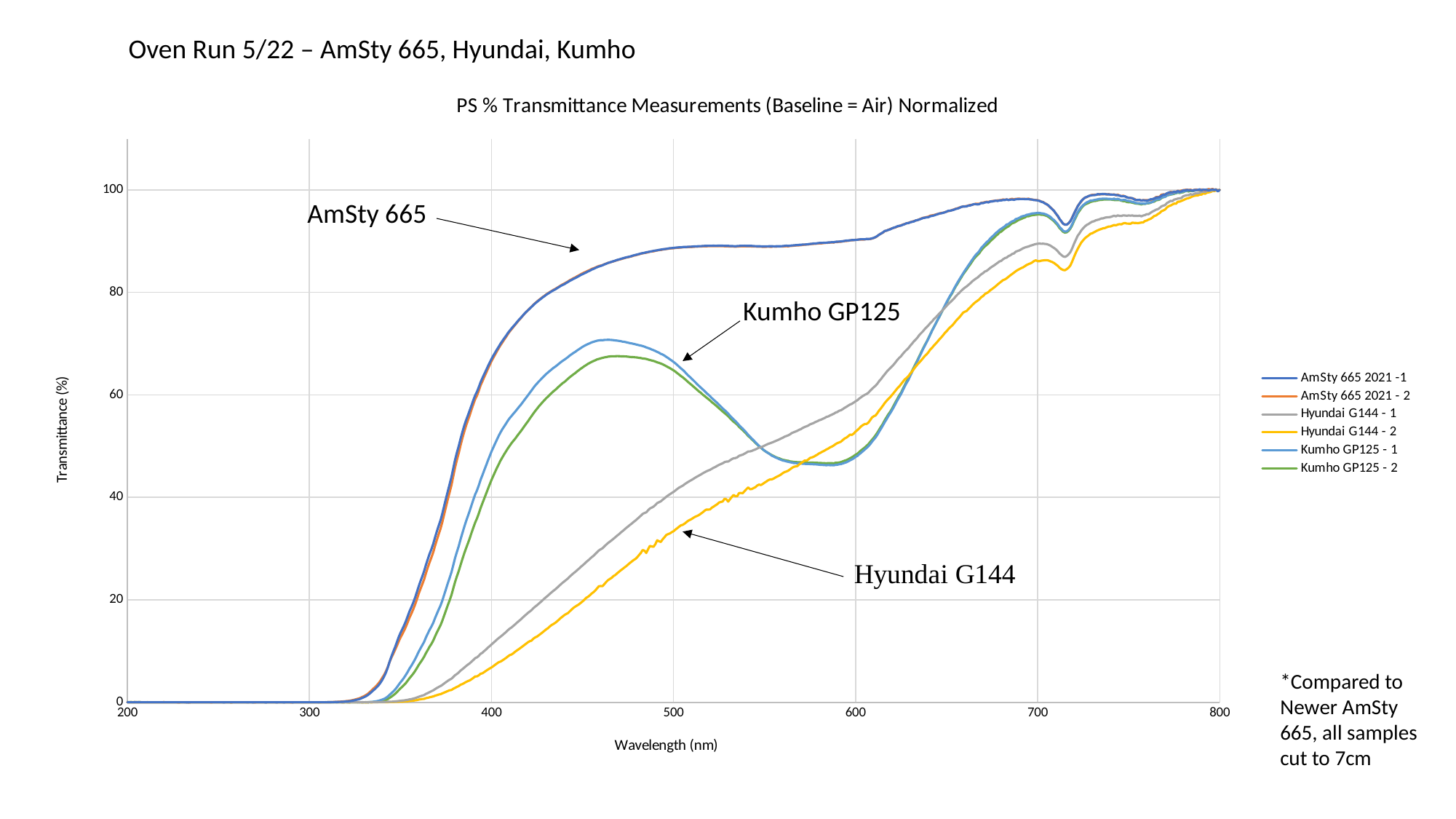
At 600 nm, which is higher: Hyundai G144 - 1 or Kumho GP125 - 2? Hyundai G144 - 1 Which series has the lowest transmittance at 500 nm? Hyundai G144 - 2 How many series does the legend list? 6 What is the label of the x axis? Wavelength (nm) Between 300 nm and 400 nm, does the AmSty 665 2021 -1 line rise or fall? rise Is the value for Kumho GP125 - 1 at 600 nm greater or less than 60? less At 500 nm, which is higher: AmSty 665 2021 -1 or Hyundai G144 - 2? AmSty 665 2021 -1 Is the value for Kumho GP125 - 1 at 700 nm greater or less than 80? greater What kind of chart is shown on the slide? line chart Is the value for AmSty 665 2021 -1 at 500 nm greater or less than 80? greater What is the title of the chart? PS % Transmittance Measurements (Baseline = Air) Normalized